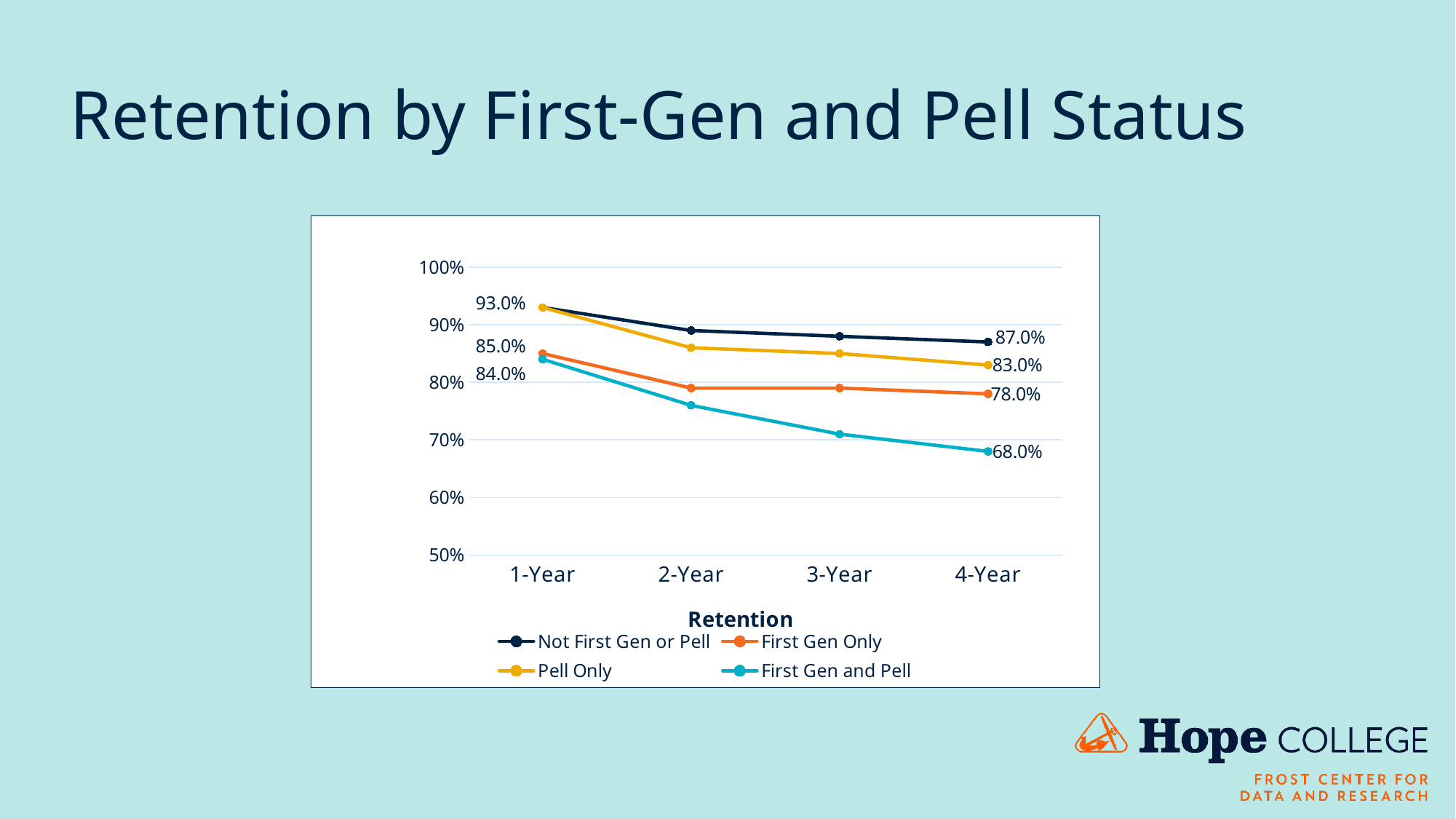
Do the retention values rise or fall from 1-Year to 4-Year? Fall Which series has the lowest retention at 4-Year? First Gen and Pell What is the 1-Year retention value for First Gen Only? 85.0% Is the 2-Year retention value for First Gen and Pell greater or less than 70%? greater Which series has the highest retention at 4-Year? Not First Gen or Pell What is the 4-Year retention value for First Gen and Pell? 68.0% How many series does the legend list? 4 What is the 4-Year retention value for Not First Gen or Pell? 87.0% What is the difference between the 4-Year retention of Not First Gen or Pell and First Gen and Pell? 19.0% How many points are on the x axis? 4 What type of chart is shown on the slide? Line chart What is the 1-Year retention value for Pell Only? 93.0%